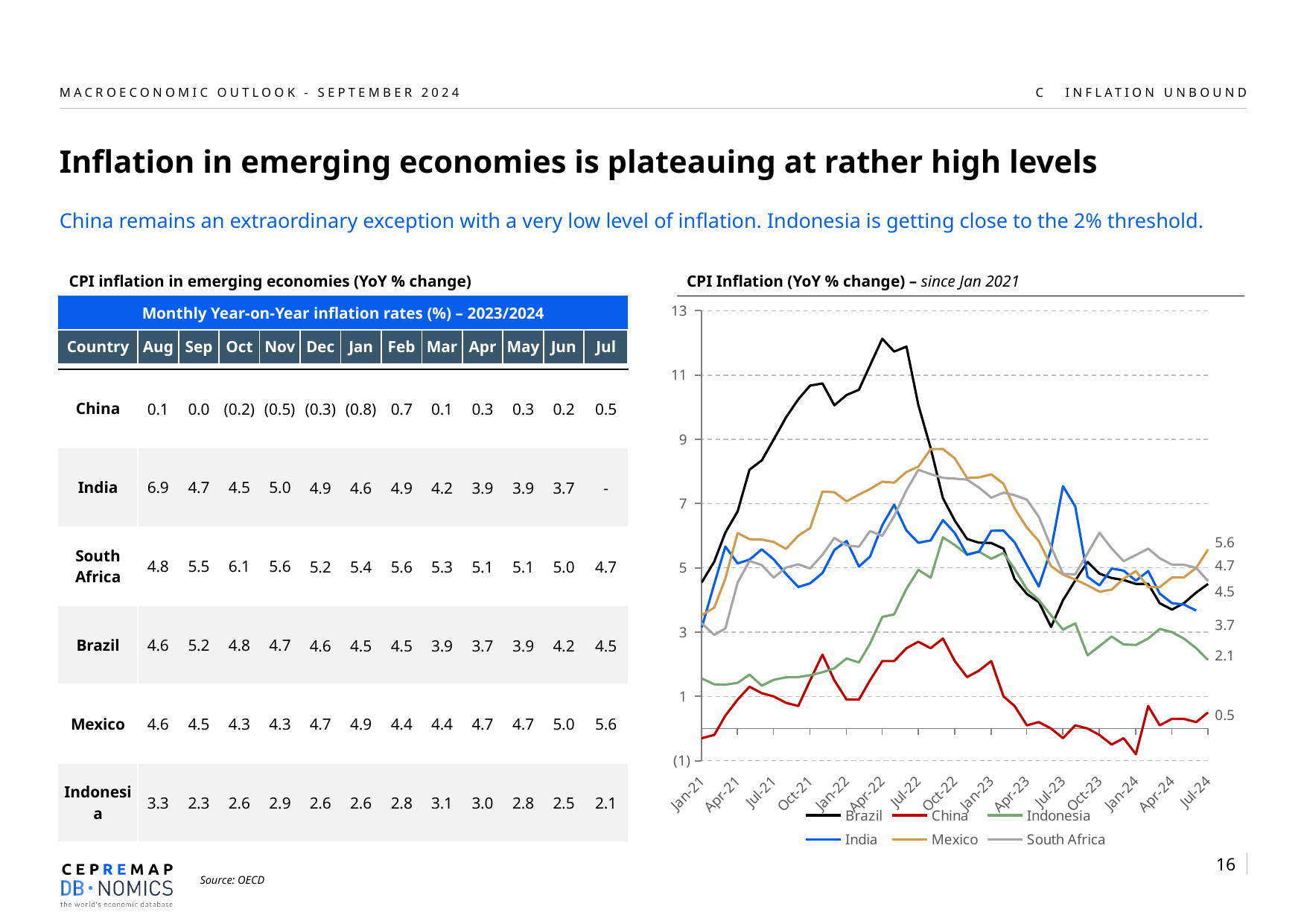
In the CPI Inflation chart, what is the latest labelled value for Mexico? 5.6 In the CPI Inflation chart, what is the latest labelled value for China? 0.5 How many series does the legend of the CPI Inflation chart list? 6 In the CPI Inflation chart, is the peak value for Brazil greater or less than 11? greater In the CPI Inflation chart, which country has the highest latest labelled value? Mexico In the CPI Inflation chart, does the Brazil line rise or fall between Jan-21 and Apr-22? rise In the CPI Inflation chart, what is the latest labelled value for Indonesia? 2.1 In the CPI Inflation chart, is the latest labelled value for Brazil or India larger? Brazil In the CPI Inflation chart, what is the difference between the latest labelled values for Mexico and China? 5.1 In the CPI Inflation chart, what is the latest labelled value for Brazil? 4.5 In the CPI Inflation chart, which country has the lowest latest labelled value? China What type of chart is shown on the right of the slide? line chart